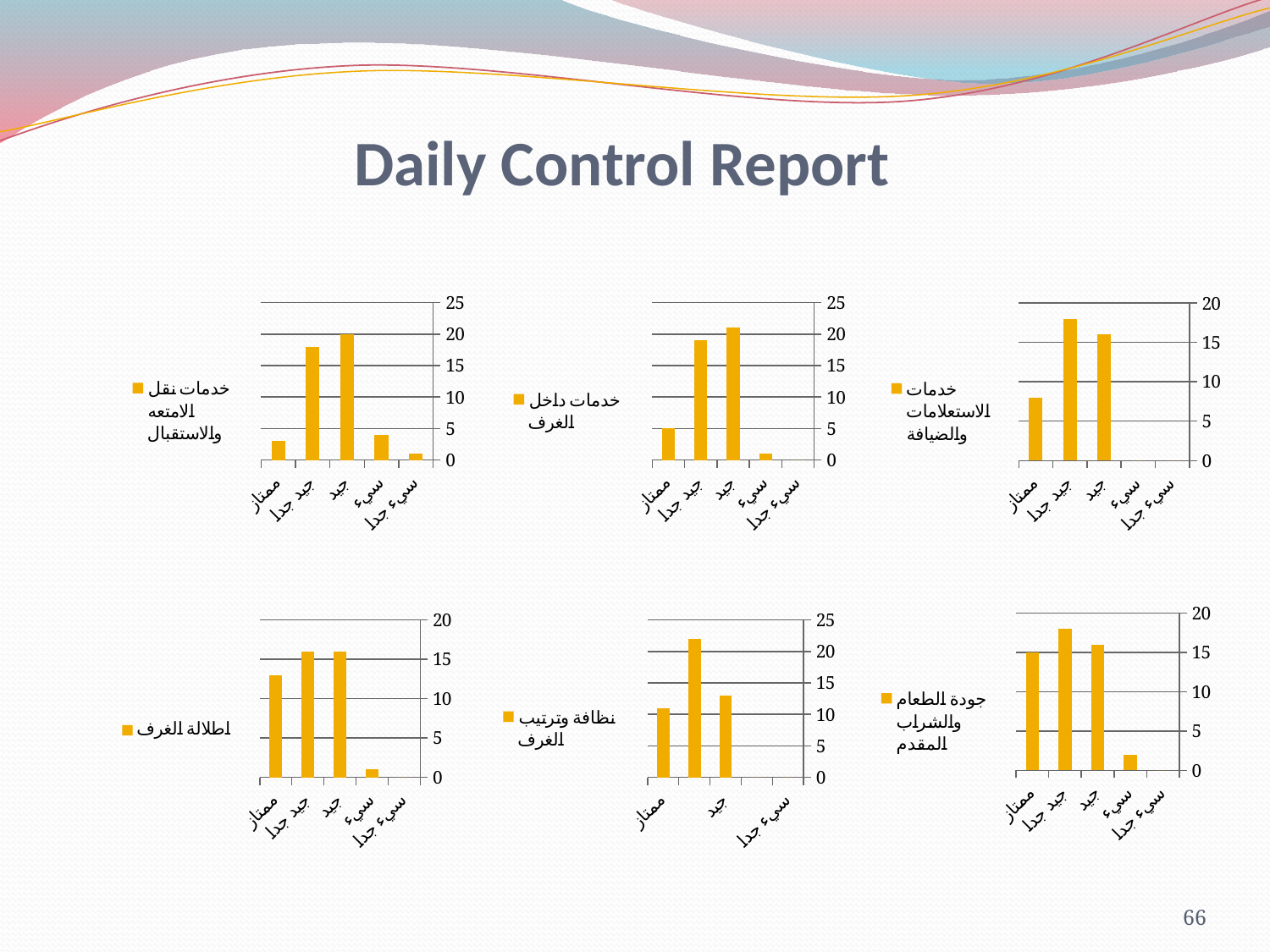
In the top-left chart (legend "خدمات نقل الامتعه والاستقبال"), is the value for ممتاز greater or less than 5? less In the bottom-left chart (legend "اطلالة الغرف"), which category has the lowest bar among those with a visible bar? سيء In the top-middle chart (legend "خدمات داخل الغرف"), which category has the highest bar? جيد In the bottom-middle chart (legend "نظافة وترتيب الغرف"), is the value for جيد greater or less than 20? less How many charts are shown on the slide? 6 What is the maximum value shown on the vertical axis of the bottom-left chart (legend "اطلالة الغرف")? 20 In the top-right chart (legend "خدمات الاستعلامات والضيافة"), which category has the highest bar? جيد جدا What kind of chart is the top-right chart (legend "خدمات الاستعلامات والضيافة")? bar chart In the top-middle chart (legend "خدمات داخل الغرف"), which is larger, the value for ممتاز or the value for جيد جدا? جيد جدا How many series does the legend of the top-left chart ("خدمات نقل الامتعه والاستقبال") list? 1 In the bottom-right chart (legend "جودة الطعام والشراب المقدم"), is the value for ممتاز greater or less than 10? greater